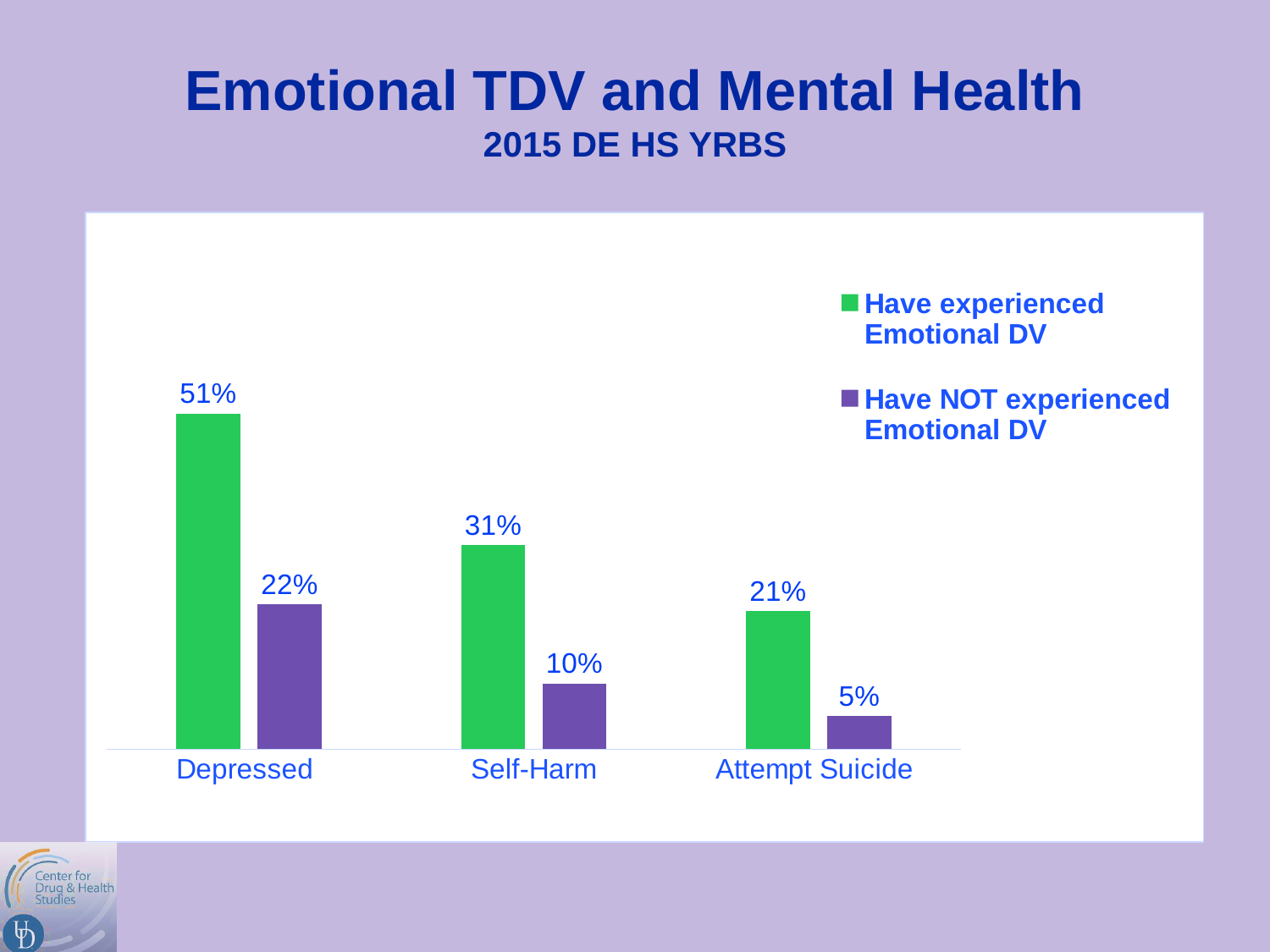
What kind of chart is shown on the slide? Bar chart What percentage of students who have experienced Emotional DV reported being Depressed? 51% Which is larger: the Attempt Suicide value for students who have experienced Emotional DV or the Depressed value for students who have NOT experienced Emotional DV? Depressed value for students who have NOT experienced Emotional DV What is the difference between the Self-Harm values for the two groups? 21% What is the value for Self-Harm among students who have NOT experienced Emotional DV? 10% Which category has the lowest value for students who have NOT experienced Emotional DV? Attempt Suicide Which category has the highest value for students who have experienced Emotional DV? Depressed What is the value for Attempt Suicide among students who have experienced Emotional DV? 21% Which colour represents students who have NOT experienced Emotional DV? Purple What is the difference between the Depressed values for students who have experienced and have NOT experienced Emotional DV? 29% How many series does the legend list? 2 How many categories are shown on the x axis? 3